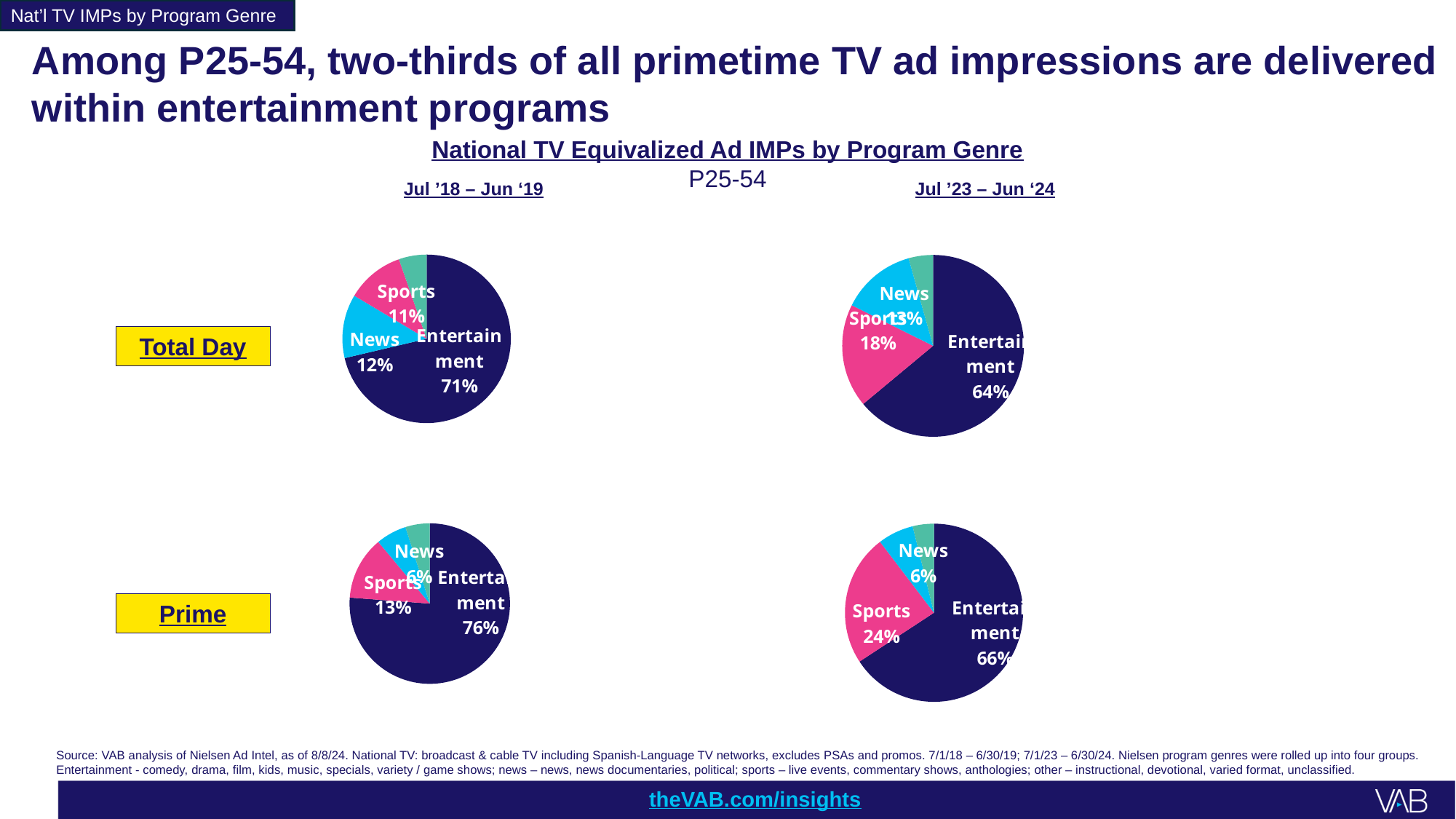
In the Prime pie chart for Jul '18 – Jun '19, which is larger, the Sports slice or the News slice? Sports Which genre has the largest slice in the Prime pie chart for Jul '23 – Jun '24? Entertainment By how many percentage points did the Sports share in Prime change from Jul '18 – Jun '19 (13%) to Jul '23 – Jun '24 (24%)? 11 percentage points In the Total Day pie chart for Jul '18 – Jun '19, what share of ad impressions is Entertainment? 71% In the Total Day pie chart for Jul '18 – Jun '19, what share is Sports? 11% In the Prime pie chart for Jul '18 – Jun '19, what share is Entertainment? 76% In the Total Day pie chart for Jul '18 – Jun '19, what share is News? 12% In the Total Day pie chart for Jul '23 – Jun '24, what share is Sports? 18% What type of chart is used on this slide? Pie chart In the Total Day pie chart for Jul '23 – Jun '24, what share is Entertainment? 64% In the Prime pie chart for Jul '23 – Jun '24, what share is Sports? 24% In the Prime pie chart for Jul '23 – Jun '24, what share is News? 6%